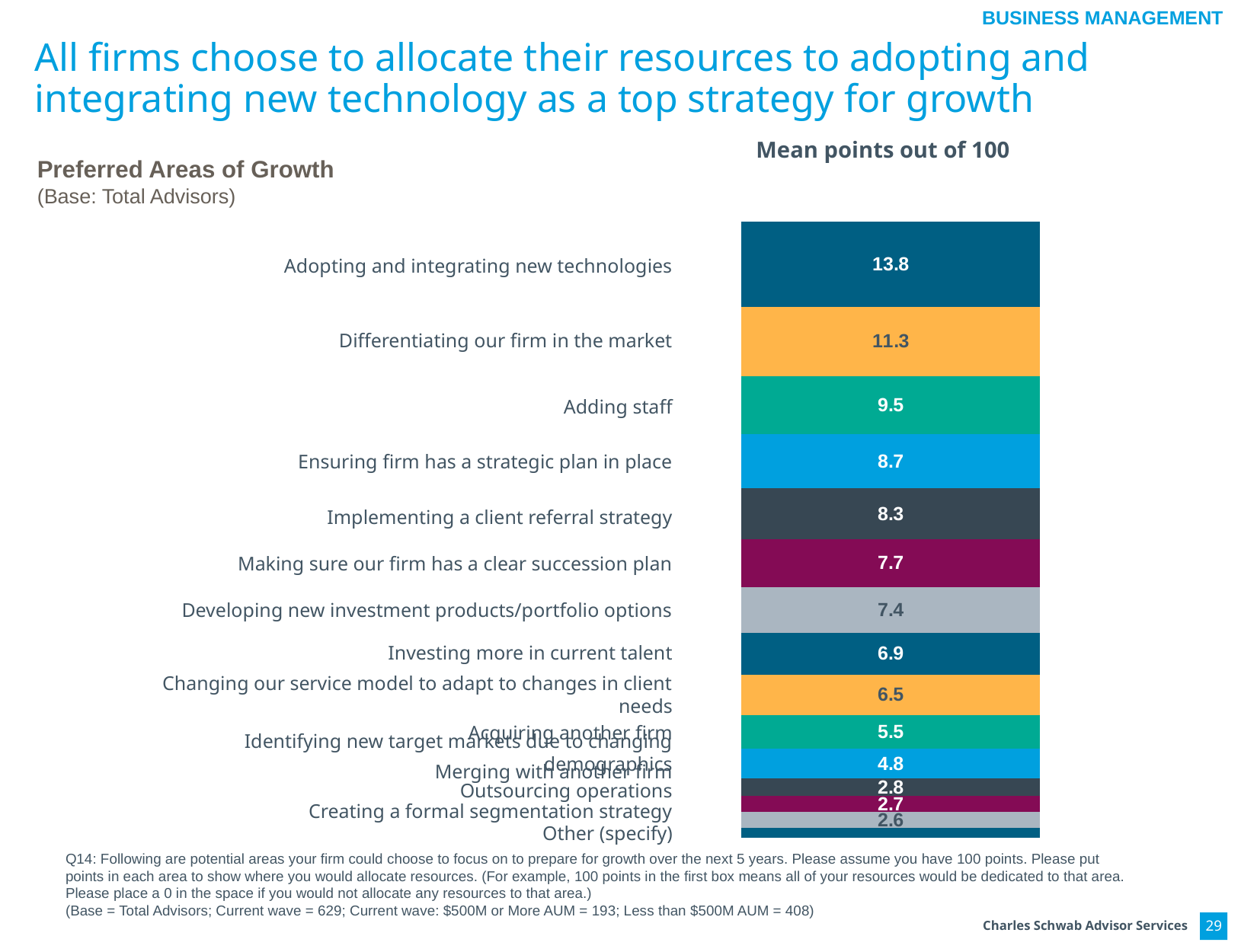
What is the mean points value for Investing more in current talent? 6.9 What kind of chart is shown on the slide? Stacked bar chart What is the title shown above the chart? Mean points out of 100 What is the mean points value for Adding staff? 9.5 Which has a higher mean points value: Adding staff or Implementing a client referral strategy? Adding staff What is the mean points value for Adopting and integrating new technologies? 13.8 Which area of growth has the highest mean points? Adopting and integrating new technologies What is the mean points value for Differentiating our firm in the market? 11.3 What is the mean points value for Ensuring firm has a strategic plan in place? 8.7 What is the difference in mean points between Developing new investment products/portfolio options and Investing more in current talent? 0.5 What is the difference in mean points between Adopting and integrating new technologies and Differentiating our firm in the market? 2.5 What is the mean points value for Making sure our firm has a clear succession plan? 7.7